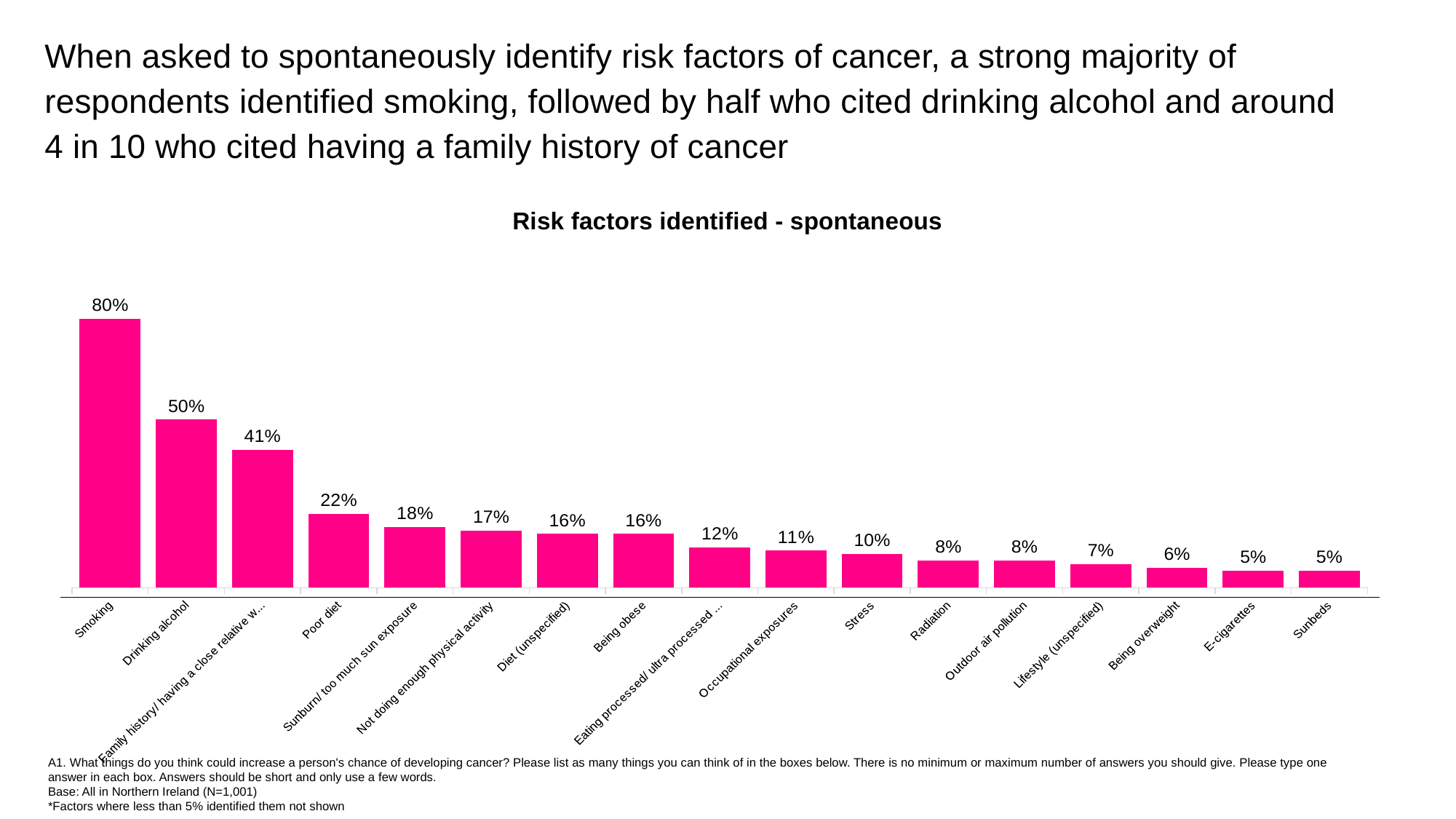
What is the title of the chart? Risk factors identified - spontaneous How many risk factors are shown in the chart? 17 Which risk factor has the highest percentage? Smoking Which is larger, the value for Radiation or the value for Stress? Stress What is the difference between the values for Poor diet and Sunburn/ too much sun exposure? 4% What is the difference between the values for Smoking and Drinking alcohol? 30% What percentage is shown for Poor diet? 22% What type of chart is shown on the slide? Bar chart What is the value for Being overweight? 6% What is the value shown for Drinking alcohol? 50% What is the value for Stress? 10% What percentage of respondents identified smoking as a risk factor? 80%